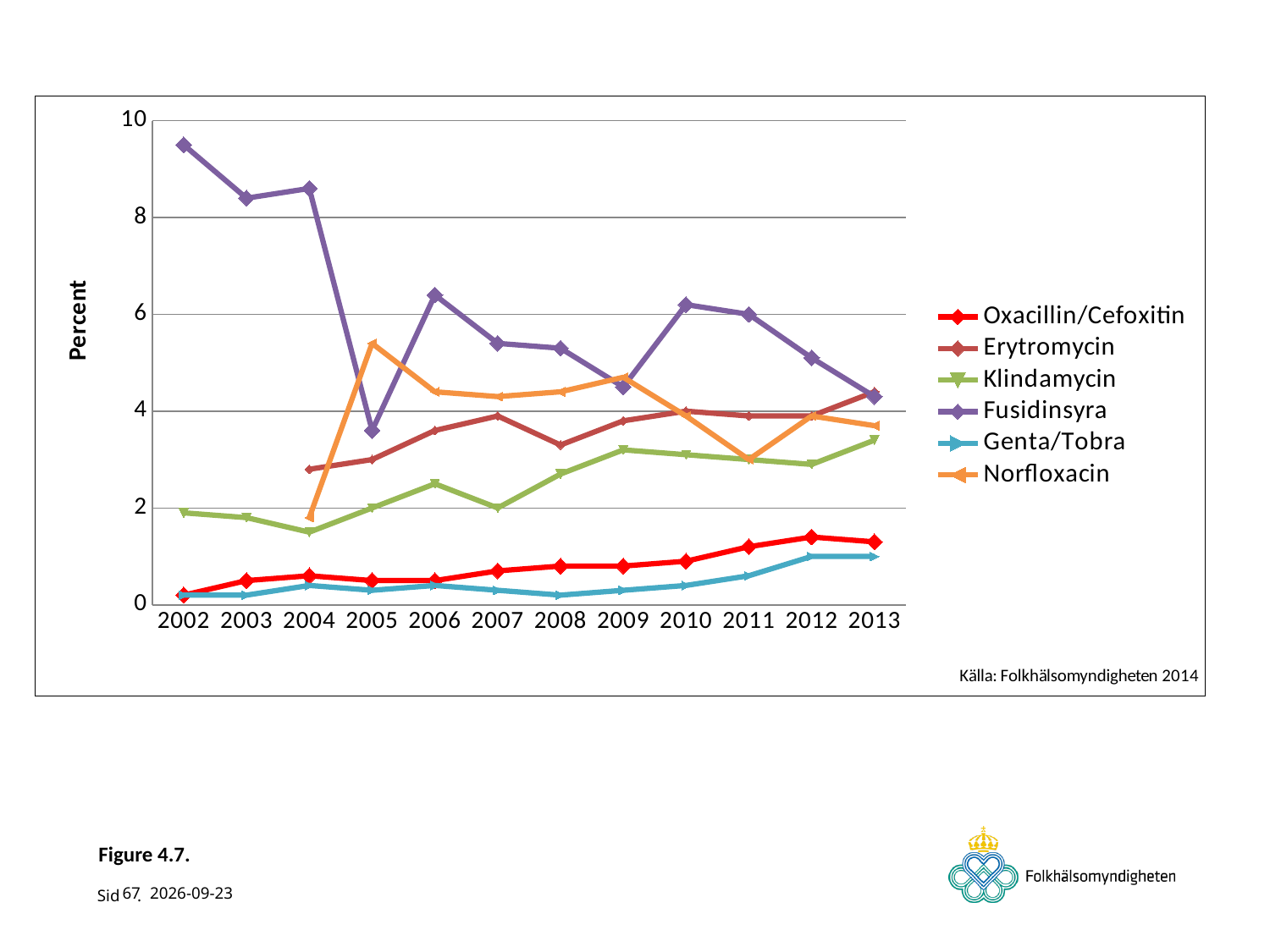
Which series has the lowest value in 2013? Genta/Tobra Does the Fusidinsyra line rise or fall overall from 2002 to 2013? fall What is the label on the y axis? Percent Is the value for Fusidinsyra in 2002 greater or less than 8? greater Is the value for Norfloxacin in 2005 greater or less than 4? greater Which series has the highest value in 2002? Fusidinsyra How many series does the legend list? 6 In 2006, which is higher: Fusidinsyra or Norfloxacin? Fusidinsyra Is the value for Klindamycin in 2004 greater or less than 2? less How many years are shown on the x axis? 12 What kind of chart is shown on the slide? line chart